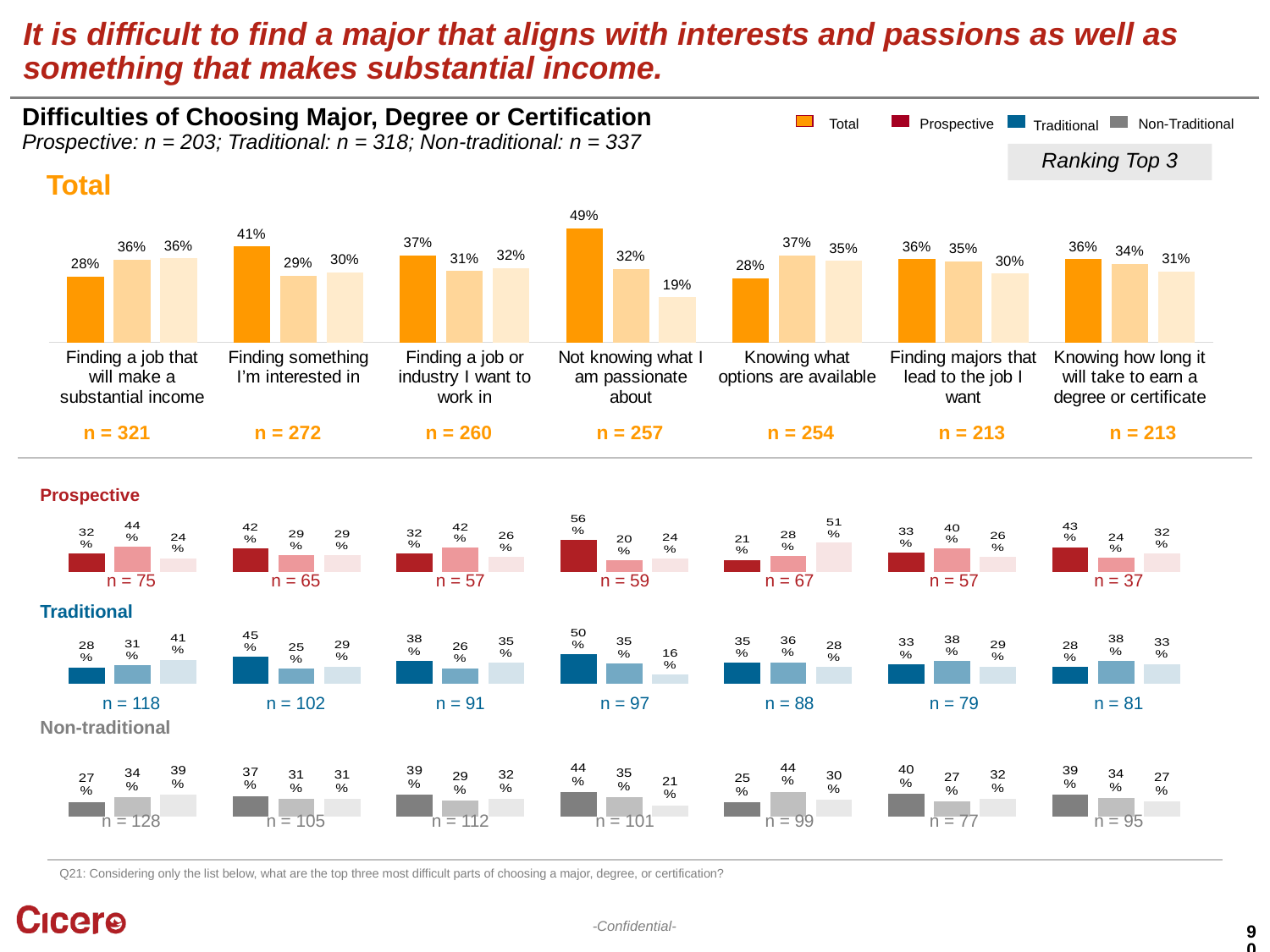
In the Total row of the chart, which is larger: the leftmost bar for "Finding a job or industry I want to work in" or the leftmost bar for "Knowing what options are available"? Finding a job or industry I want to work in How many groups does the legend at the top of the chart list? 4 What type of chart is used on this slide? Bar chart In the Non-traditional row of the chart, what is the sample size (n) shown for "Finding a job that will make a substantial income"? n = 128 In the Traditional row of the chart, what is the value of the leftmost bar for "Finding something I'm interested in"? 45% How many categories (difficulties) are shown along the x axis of the Total row of the chart? 7 In the Total row of the chart, what is the value of the leftmost bar for "Not knowing what I am passionate about"? 49% In the Total row of the chart, what is the difference between the leftmost bar (41%) and the middle bar (29%) for "Finding something I'm interested in"? 12% In the Total row of the chart, what is the sample size (n) shown for "Finding a job that will make a substantial income"? n = 321 In the Prospective row of the chart, what is the value of the rightmost bar for "Knowing what options are available"? 51% In the Total row of the chart, what is the value of the rightmost bar for "Not knowing what I am passionate about"? 19% In the Total row of the chart, which category has the highest leftmost-bar value? Not knowing what I am passionate about